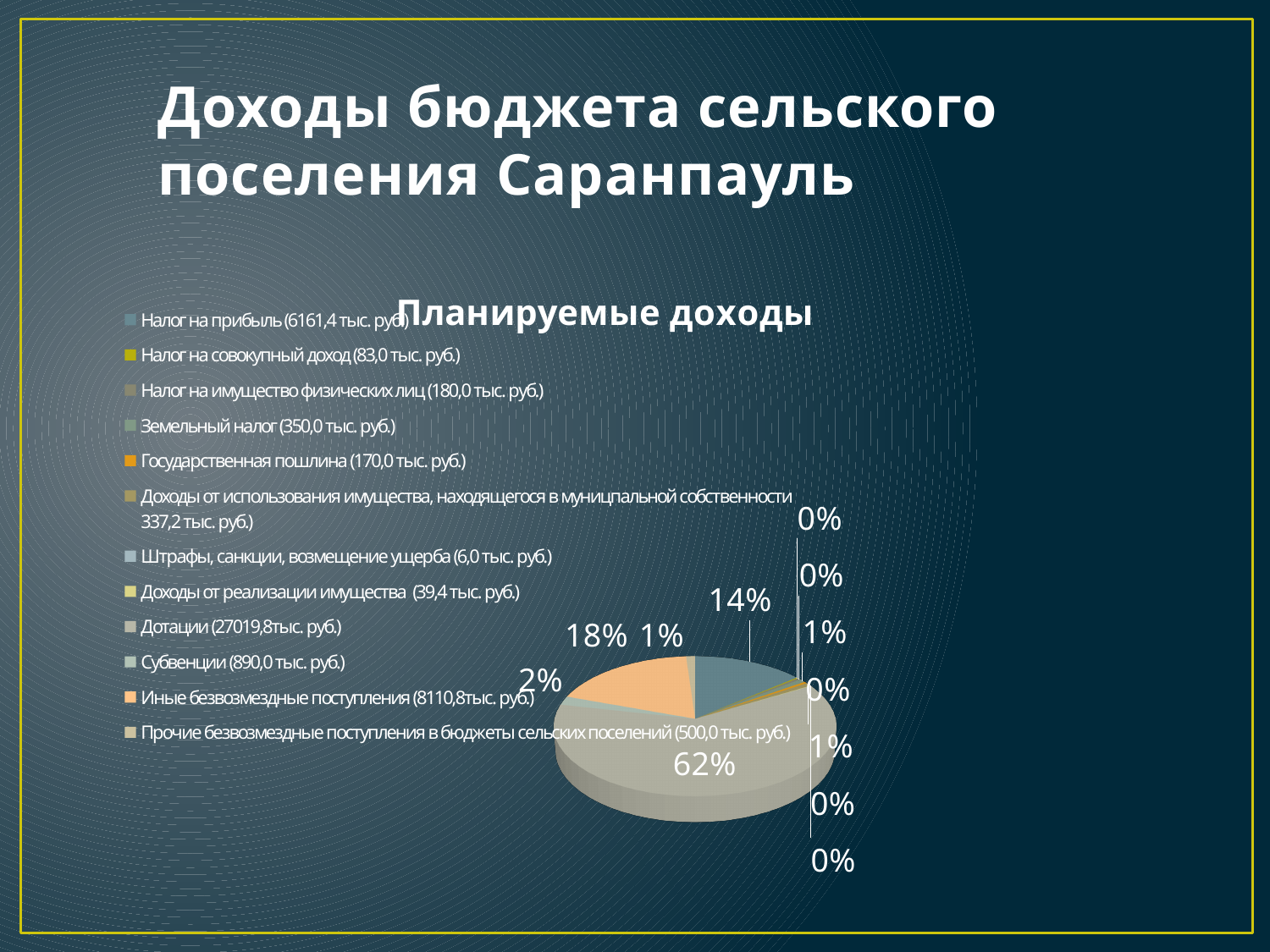
What share of the pie is labelled for the blue-grey slice (Налог на прибыль)? 14% What amount is given in the legend for Дотации? 27019,8 тыс. руб. How many entries does the chart legend list? 12 What is the title of the chart? Планируемые доходы What share of the pie does the largest slice (Дотации) take? 62% What share of the pie is labelled for the orange slice (Иные безвозмездные поступления)? 18% What kind of chart is shown on the slide? pie chart What is the largest percentage label shown on the pie chart? 62% Which is larger: the 62% slice or the 18% slice? the 62% slice What is the difference between the 62% slice and the 14% slice? 48% What amount is given in the legend for Субвенции? 890,0 тыс. руб. What amount is given in the legend for Налог на прибыль? 6161,4 тыс. руб.